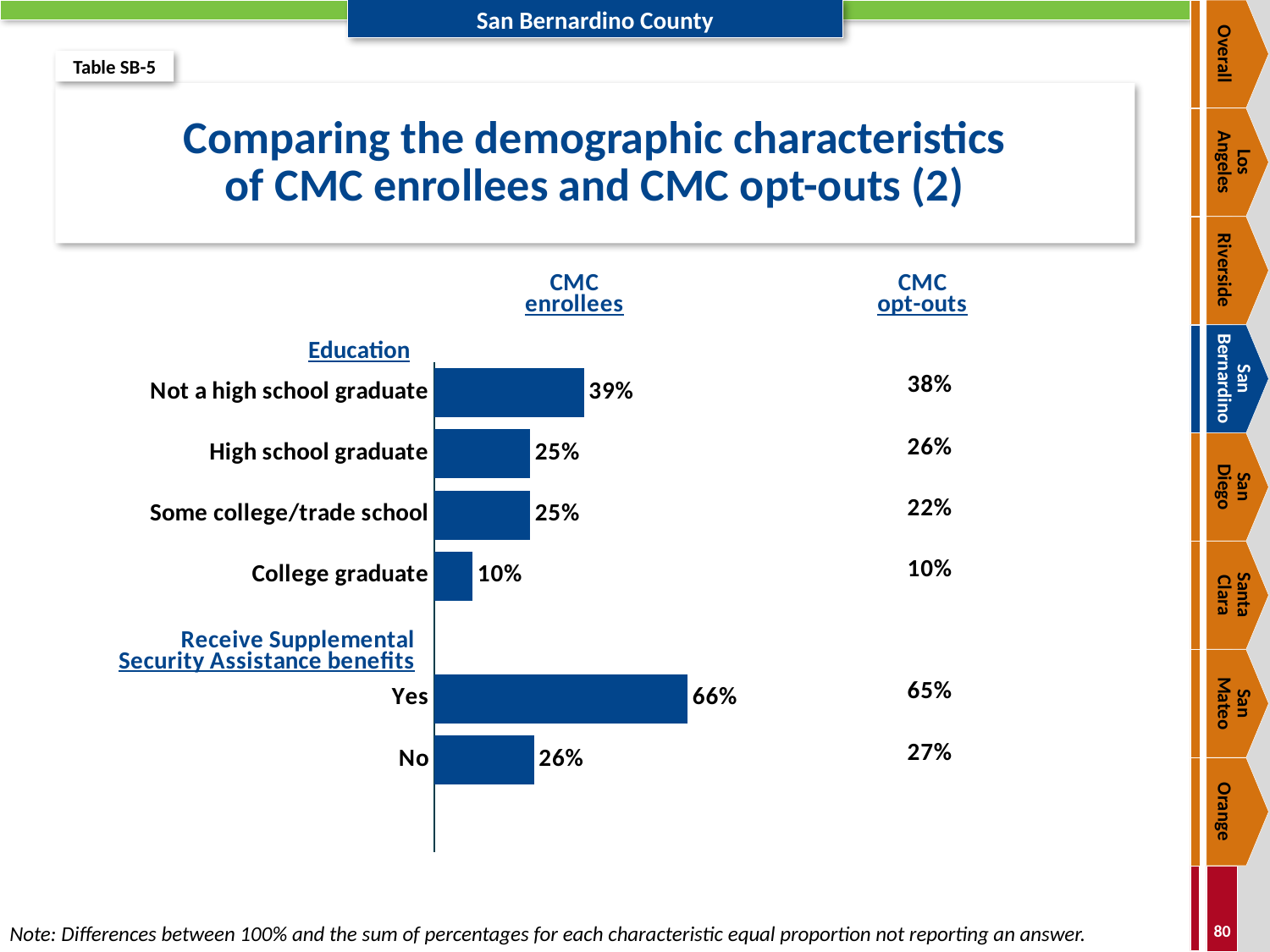
Among the Education categories, which has the lowest percentage of CMC enrollees? College graduate Which is larger for CMC enrollees: the percentage who are high school graduates or the percentage who are college graduates? High school graduate What percentage of CMC opt-outs have some college/trade school education? 22% What percentage of CMC enrollees are not a high school graduate? 39% What is the difference between the CMC enrollees and CMC opt-outs percentages for Not a high school graduate? 1% What are the two column headings shown above the data? CMC enrollees and CMC opt-outs What percentage of CMC enrollees receive Supplemental Security Assistance benefits (Yes)? 66% What kind of chart is used to show the CMC enrollees values? bar chart What is the difference between the percentage of CMC enrollees who answered Yes and No to receiving Supplemental Security Assistance benefits? 40% What percentage of CMC enrollees are college graduates? 10% How many bars are plotted in the CMC enrollees bar chart? 6 Among the Education categories, which has the highest percentage of CMC enrollees? Not a high school graduate